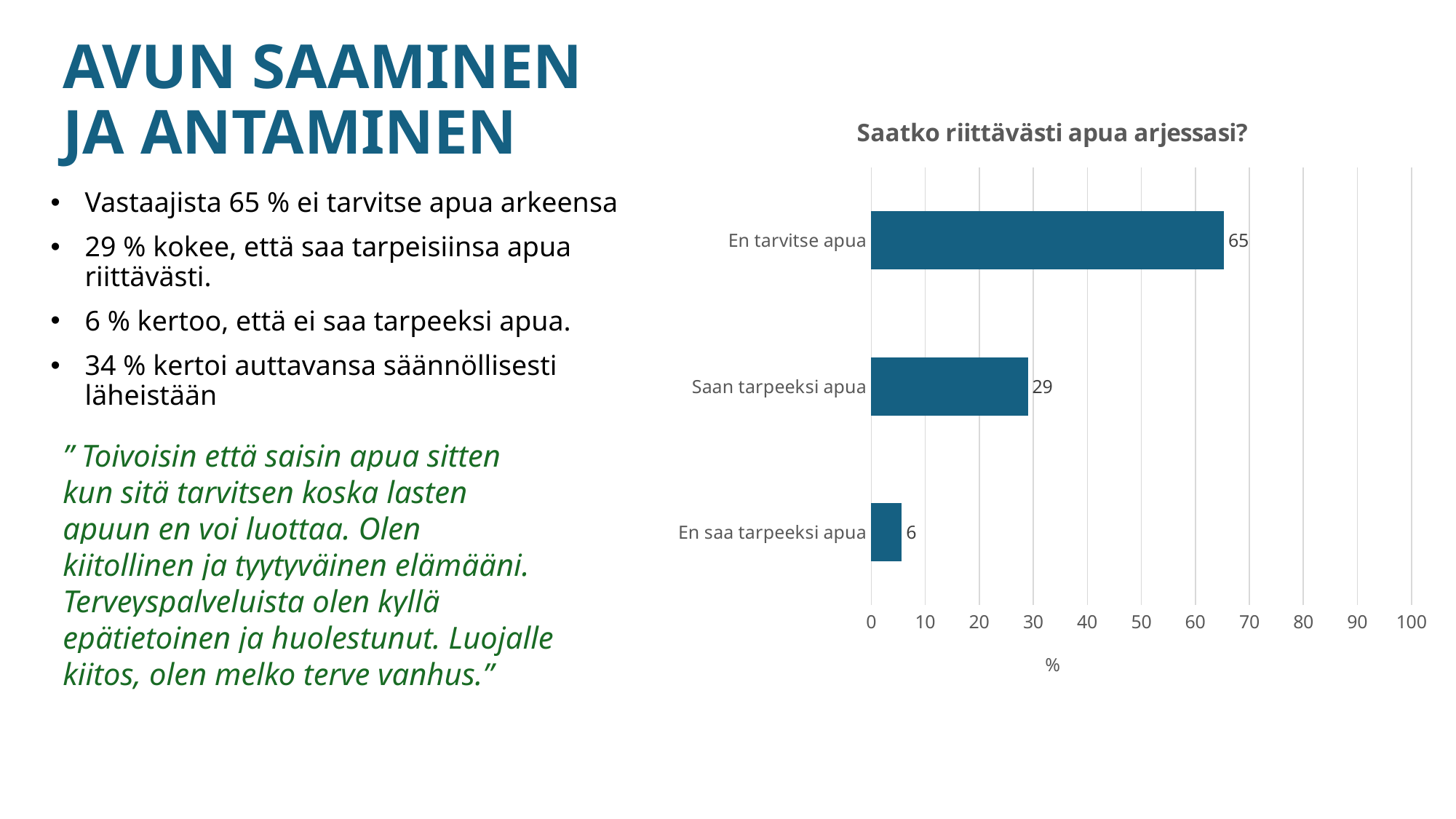
Which is larger, the value for "Saan tarpeeksi apua" or the value for "En saa tarpeeksi apua"? Saan tarpeeksi apua What kind of chart is shown on the slide? bar chart What is the difference between the values for "Saan tarpeeksi apua" and "En saa tarpeeksi apua"? 23 How many categories are shown in the chart? 3 Which category has the lowest value? En saa tarpeeksi apua What is the value for "En saa tarpeeksi apua"? 6 Which category has the highest value? En tarvitse apua What is the value for "En tarvitse apua"? 65 Is the value for "En tarvitse apua" greater or less than 50? greater What is the value for "Saan tarpeeksi apua"? 29 What is the difference between the values for "En tarvitse apua" and "Saan tarpeeksi apua"? 36 What is the title of the chart? Saatko riittävästi apua arjessasi?